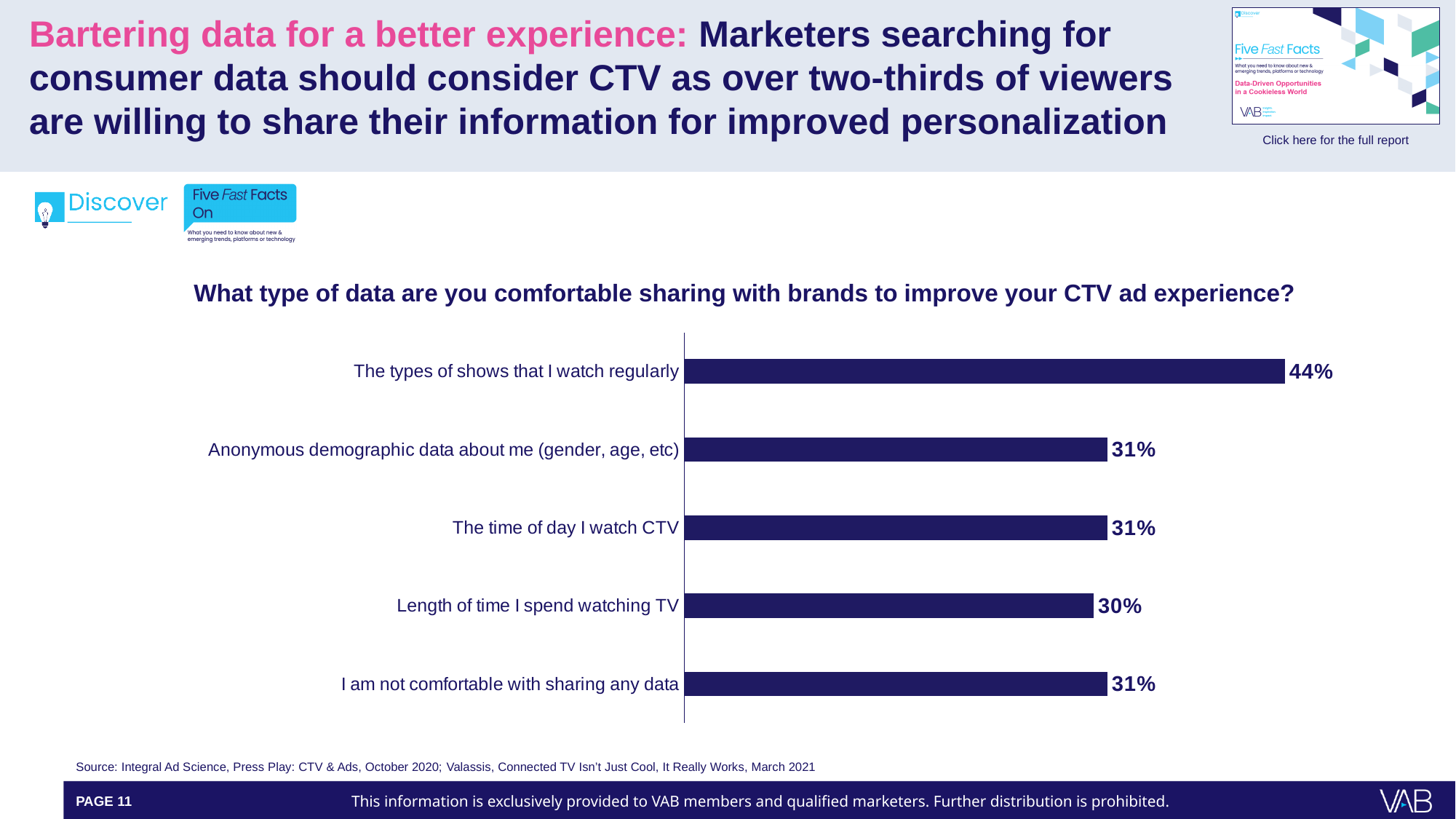
What percentage of viewers are comfortable sharing the types of shows they watch regularly? 44% What is the value for 'Anonymous demographic data about me (gender, age, etc)'? 31% What is the value for 'Length of time I spend watching TV'? 30% What is the difference between the value for 'The time of day I watch CTV' and 'Length of time I spend watching TV'? 1% Which category has the lowest value on the chart? Length of time I spend watching TV What question does the chart title ask? What type of data are you comfortable sharing with brands to improve your CTV ad experience? Which is larger: the value for 'The types of shows that I watch regularly' or 'Length of time I spend watching TV'? The types of shows that I watch regularly What percentage of viewers are not comfortable with sharing any data? 31% Which type of data has the highest share of viewers comfortable sharing it? The types of shows that I watch regularly What is the difference between the value for 'The types of shows that I watch regularly' and 'The time of day I watch CTV'? 13% How many categories are shown on the chart? 5 What kind of chart is shown on the slide? Bar chart